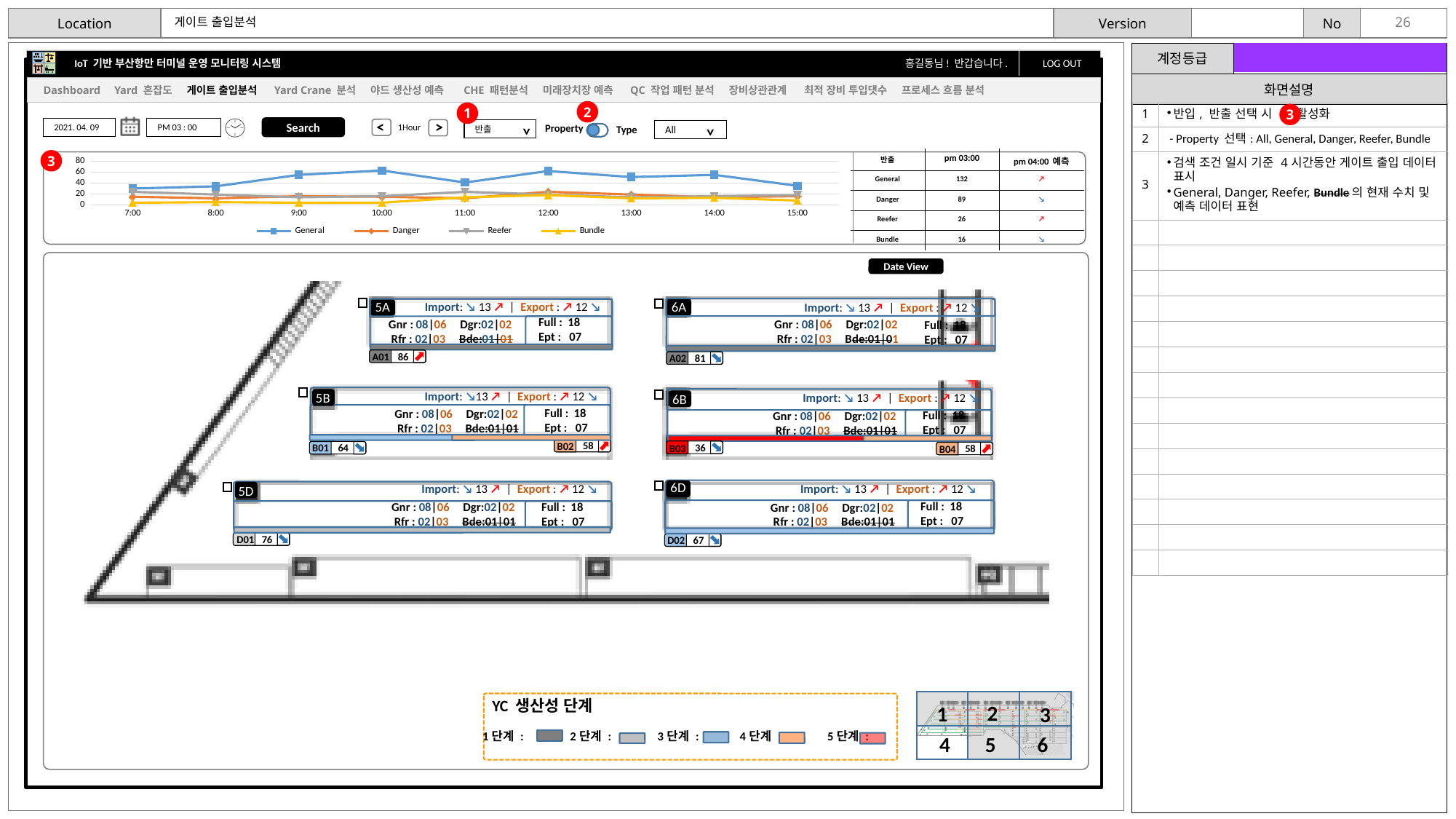
How many time points are shown along the x axis of the line chart? 9 Which series has the lowest value at 7:00 in the line chart? Bundle Is the value for Bundle at 7:00 greater or less than 20? less What is the highest tick value shown on the y axis of the line chart? 80 Is the value for Danger at 12:00 greater or less than 40? less Is the value for General at 7:00 greater or less than 40? less Which series has the highest values across the line chart? General What kind of chart is shown at the top of the dashboard? line chart At 12:00, which is larger in the line chart: General or Bundle? General How many series does the legend of the line chart list? 4 Which series are listed in the legend of the line chart? General, Danger, Reefer, Bundle